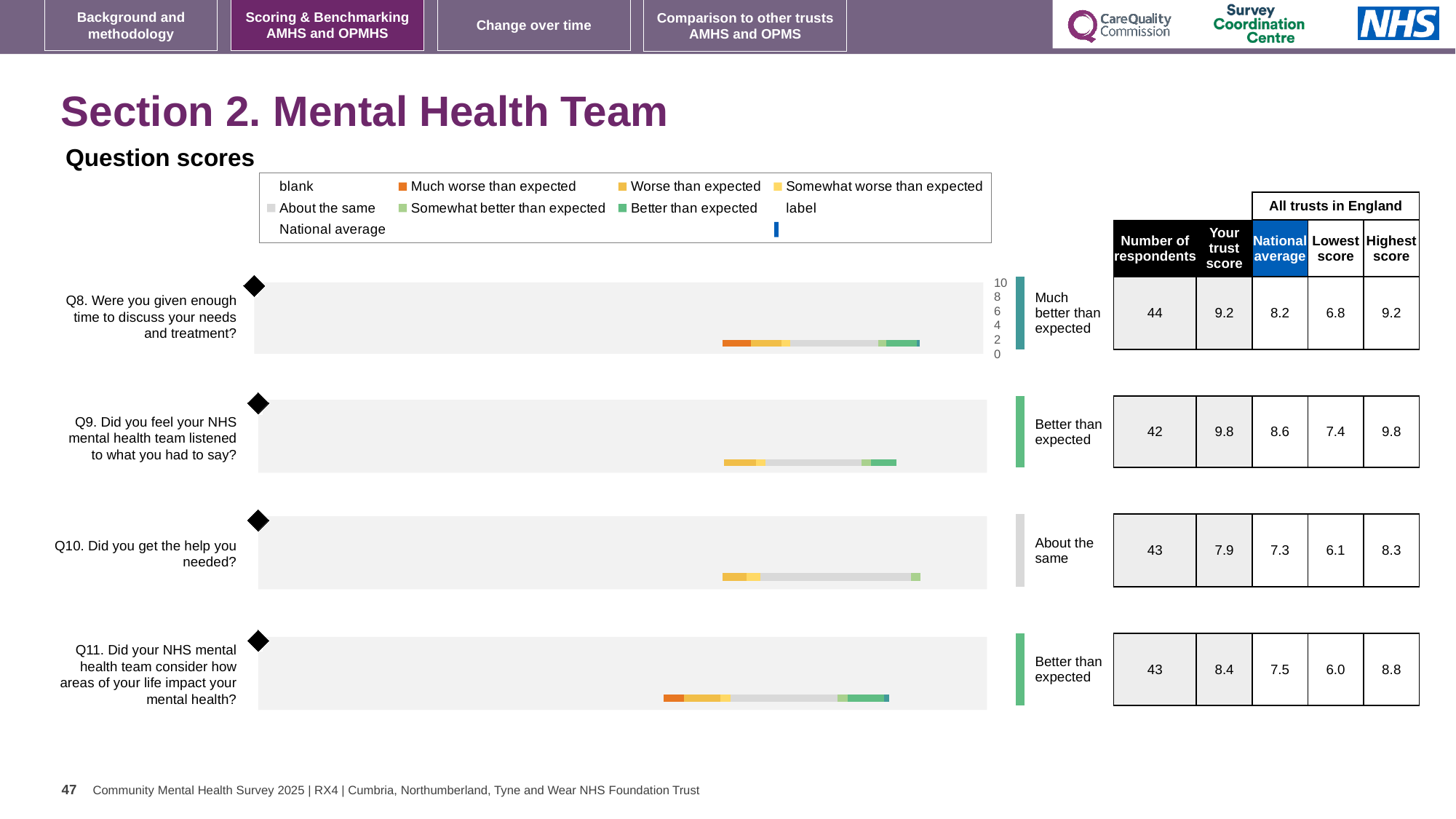
How many questions (Q8 to Q11) have a score chart on this slide? 4 What is the lowest score among all trusts in England for Q11? 6.0 Which question has the lowest national average score? Q10 How many respondents answered Q10 (Did you get the help you needed)? 43 Which has the larger 'Your trust score', Q8 or Q10? Q8 What kind of chart is used to show the question scores for Q8 to Q11? bar chart What is the 'Your trust score' for Q8 (Were you given enough time to discuss your needs and treatment)? 9.2 Which question has the highest 'Your trust score'? Q9 For Q11, what is the difference between 'Your trust score' and the national average? 0.9 For Q9, what is the difference between the highest score and the lowest score among all trusts in England? 2.4 What is the national average score for Q9 (Did you feel your NHS mental health team listened to what you had to say)? 8.6 What benchmark label is shown next to the Q8 chart? Much better than expected